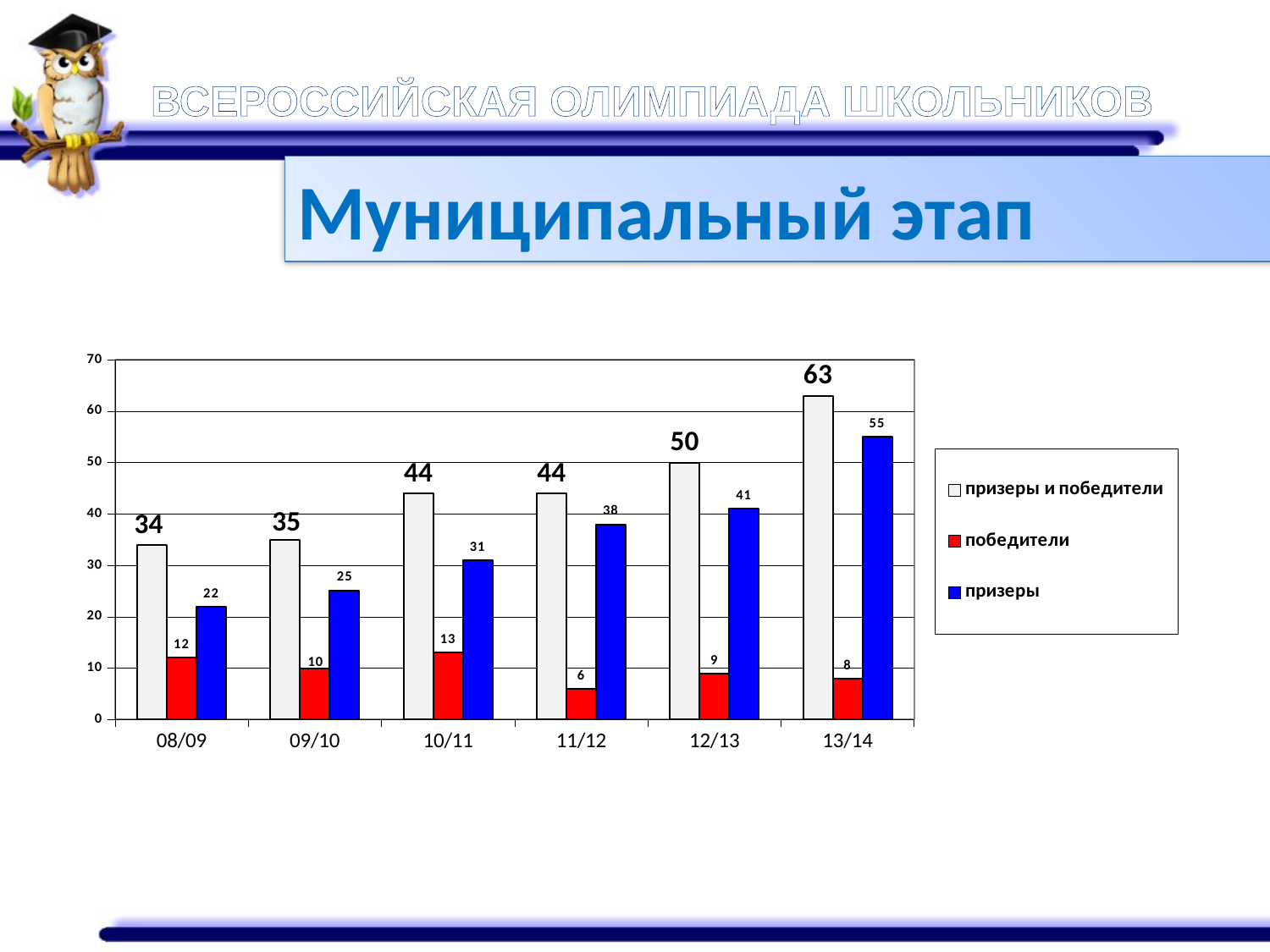
What colour are the bars for 'призеры'? blue What is the value of 'призеры и победители' for 13/14? 63 What is the value of 'победители' for 10/11? 13 Which is larger: 'победители' in 08/09 or 'победители' in 12/13? победители in 08/09 What is the value of 'призеры' for 11/12? 38 What kind of chart is shown on the slide? bar chart Does the value of 'призеры' rise or fall from 08/09 to 13/14? rise Which year has the lowest value for 'победители'? 11/12 What is the difference between 'призеры' in 13/14 and 'призеры' in 08/09? 33 How many years are shown on the x axis? 6 Which year has the highest value for 'призеры и победители'? 13/14 How many series does the legend list? 3